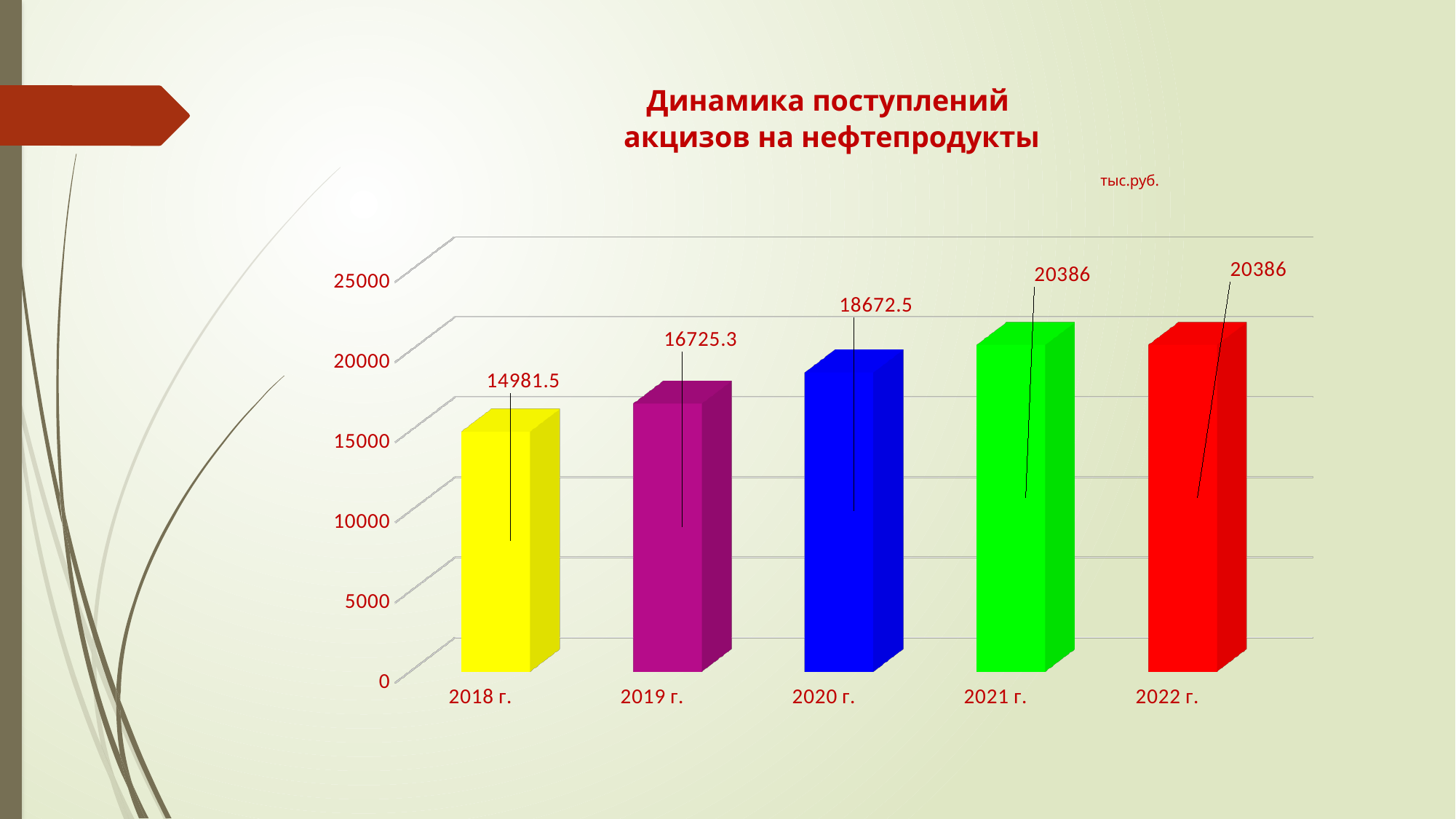
What is the difference between the values for 2021 г. and 2020 г.? 1713.5 Do the values rise or fall from 2018 г. to 2021 г.? rise What is the value for 2018 г.? 14981.5 Is the value for 2018 г. greater or less than 15000? less How many years are shown on the chart? 5 What kind of chart is shown on the slide? bar chart Which is larger, the value for 2019 г. or the value for 2020 г.? 2020 г. Which year has the lowest value? 2018 г. What is the value for 2022 г.? 20386 What is the value for 2020 г.? 18672.5 What unit is indicated on the chart? тыс.руб. What is the difference between the values for 2019 г. and 2018 г.? 1743.8